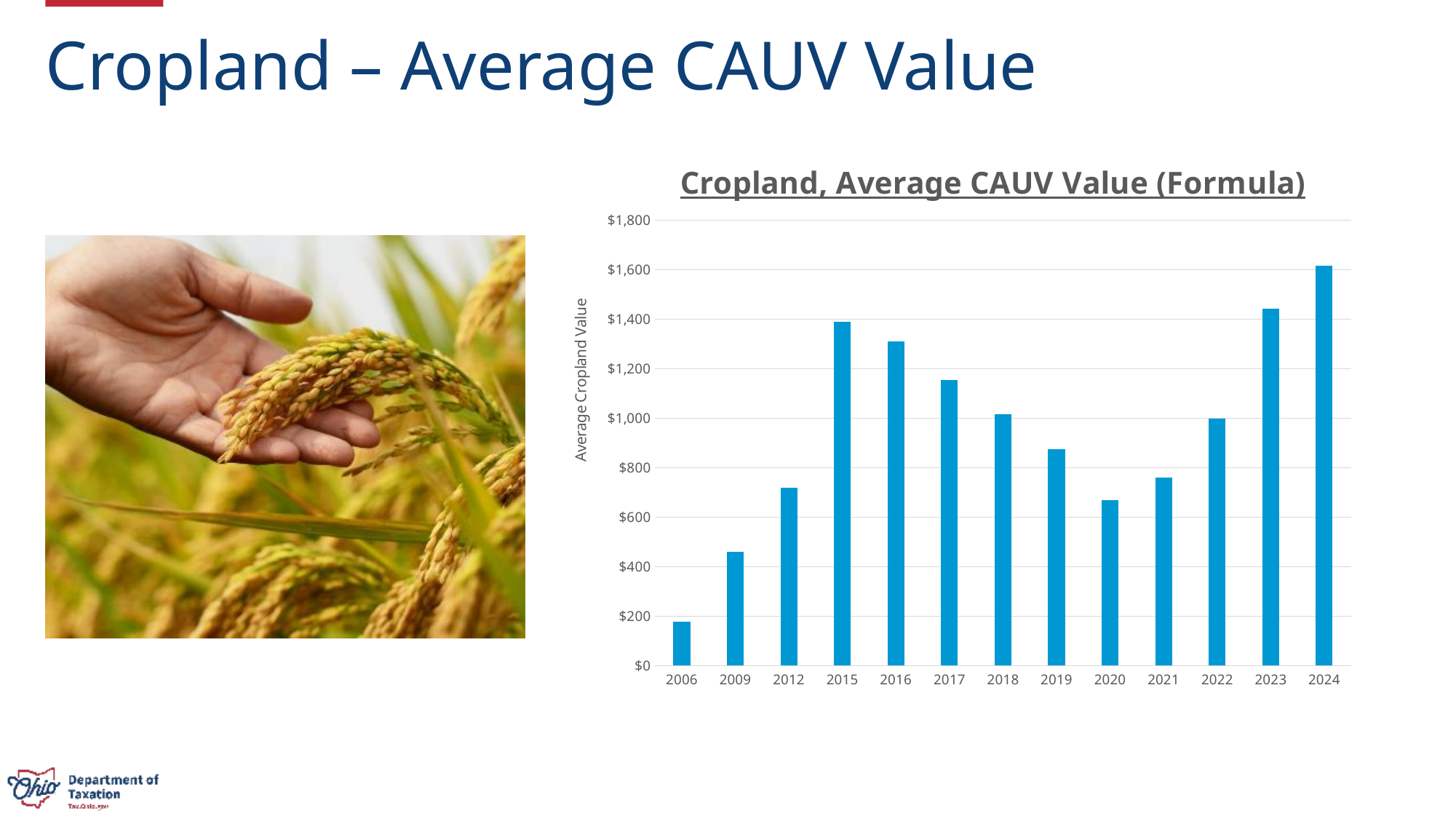
Is the value for 2021 greater or less than $800? less What is the title of the chart's vertical axis? Average Cropland Value Is the value for 2006 greater or less than $200? less Do the values rise or fall from 2015 to 2020? Fall How many years are plotted on the chart? 13 Which year has a higher average cropland value, 2020 or 2021? 2021 What kind of chart is shown on the slide? Bar chart Is the value for 2015 greater or less than $1,200? greater Which year has the highest average cropland value? 2024 Which year has the lowest average cropland value? 2006 Which year has a higher average cropland value, 2015 or 2016? 2015